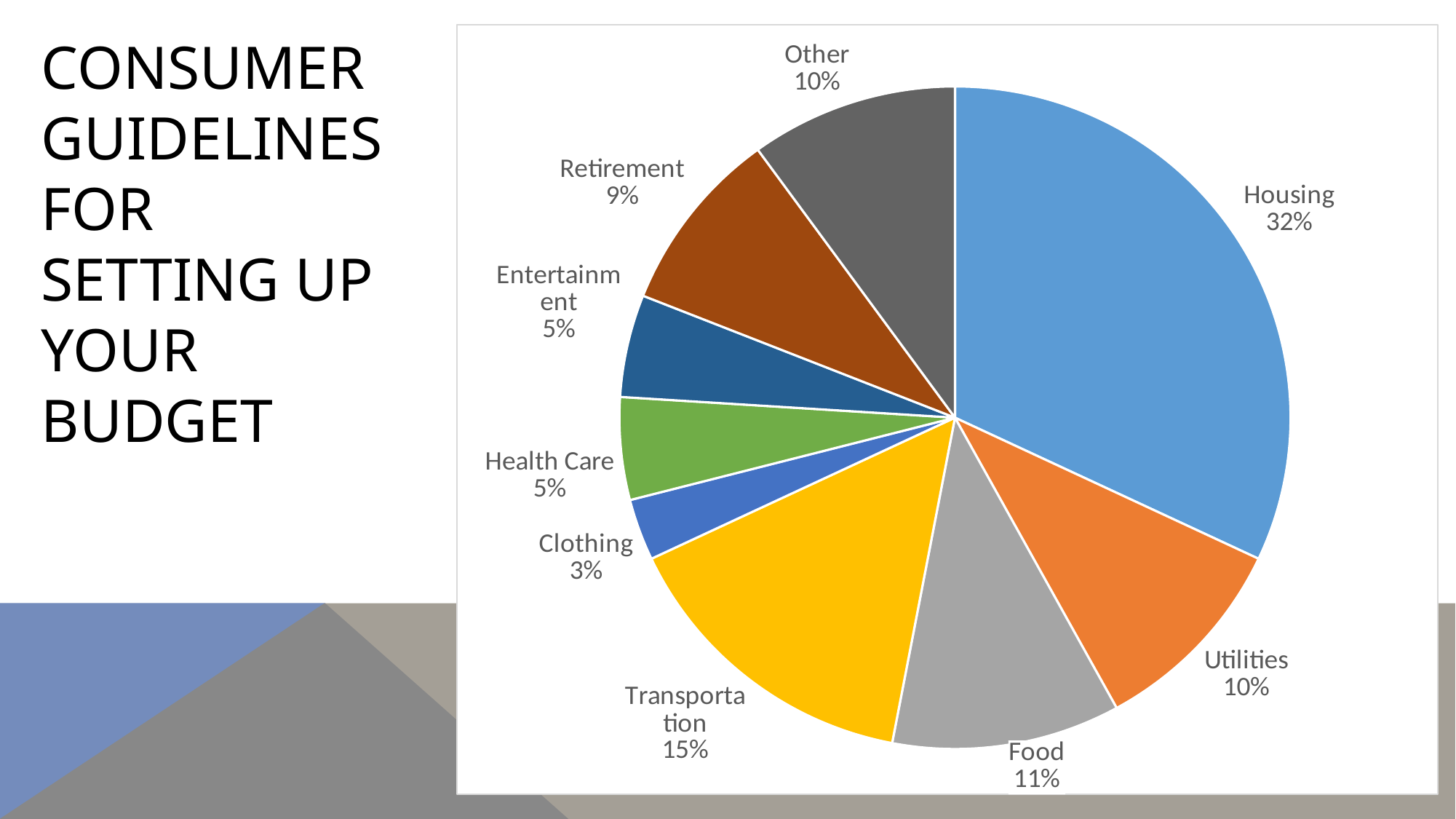
What percentage is shown for Retirement? 9% What is the title text on the left of the slide? CONSUMER GUIDELINES FOR SETTING UP YOUR BUDGET What is the difference between the Retirement and Entertainment percentages? 4% What percentage is shown for Transportation? 15% Which is larger, the Food slice or the Utilities slice? Food Which category has the largest slice of the pie? Housing Which category has the smallest slice of the pie? Clothing What kind of chart is shown on the slide? pie chart What percentage is shown for Food? 11% How many categories are shown in the pie chart? 9 What share of the budget does Housing take? 32% What is the difference between the Housing and Transportation percentages? 17%